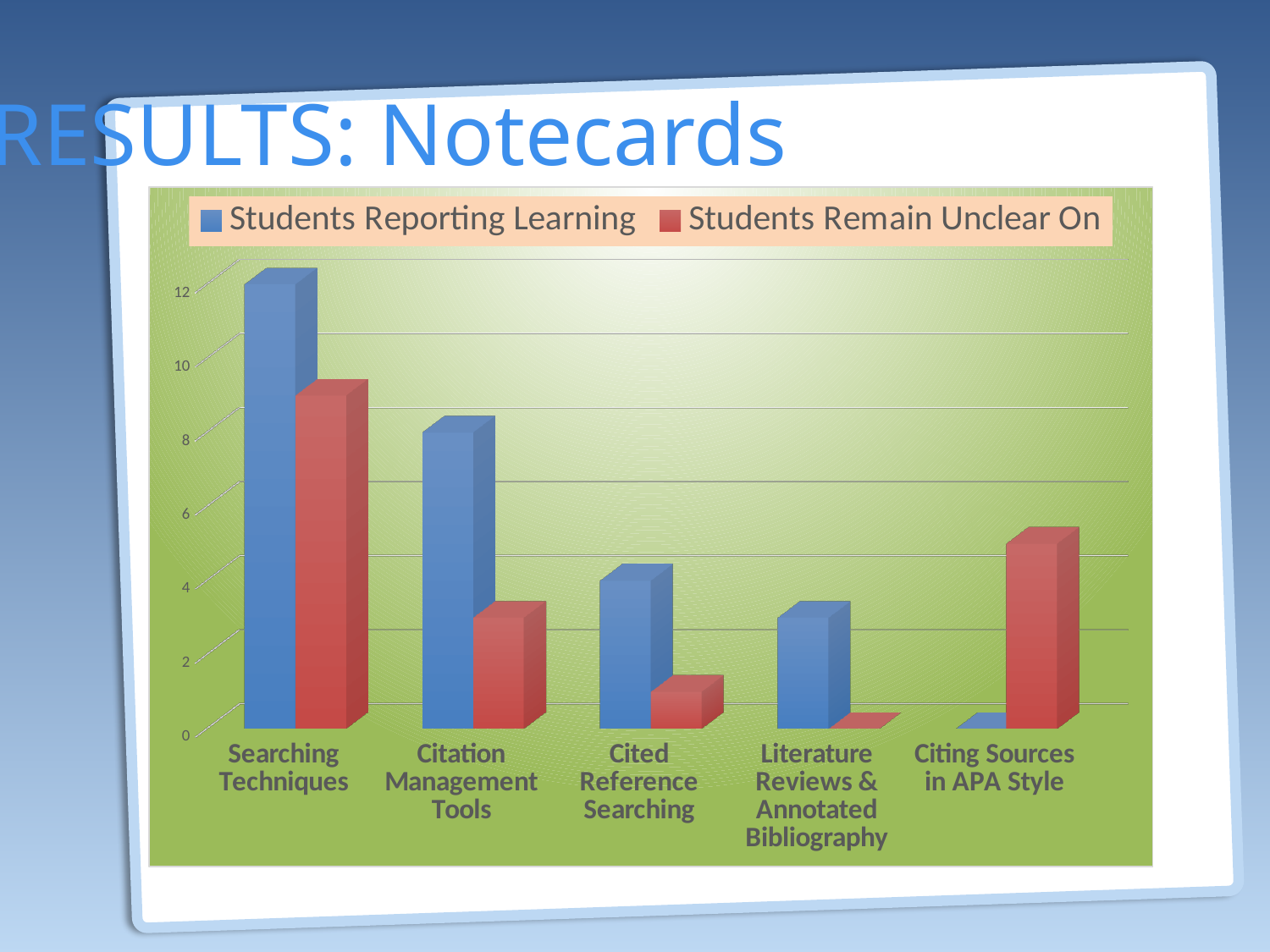
Which category has the highest value for Students Remain Unclear On? Searching Techniques Which category has the lowest value for Students Remain Unclear On? Literature Reviews & Annotated Bibliography Which category has the lowest value for Students Reporting Learning? Citing Sources in APA Style What kind of chart is shown on the slide? bar chart Is the value for Students Remain Unclear On in Citation Management Tools greater or less than 4? less Is the value for Students Reporting Learning in Searching Techniques greater or less than 10? greater For Citing Sources in APA Style, which series has the larger value? Students Remain Unclear On For Citation Management Tools, which series has the larger value? Students Reporting Learning Which category has the highest value for Students Reporting Learning? Searching Techniques Do the values for Students Reporting Learning rise or fall from left to right across the categories? fall How many categories are shown on the x axis? 5 How many series does the legend list? 2